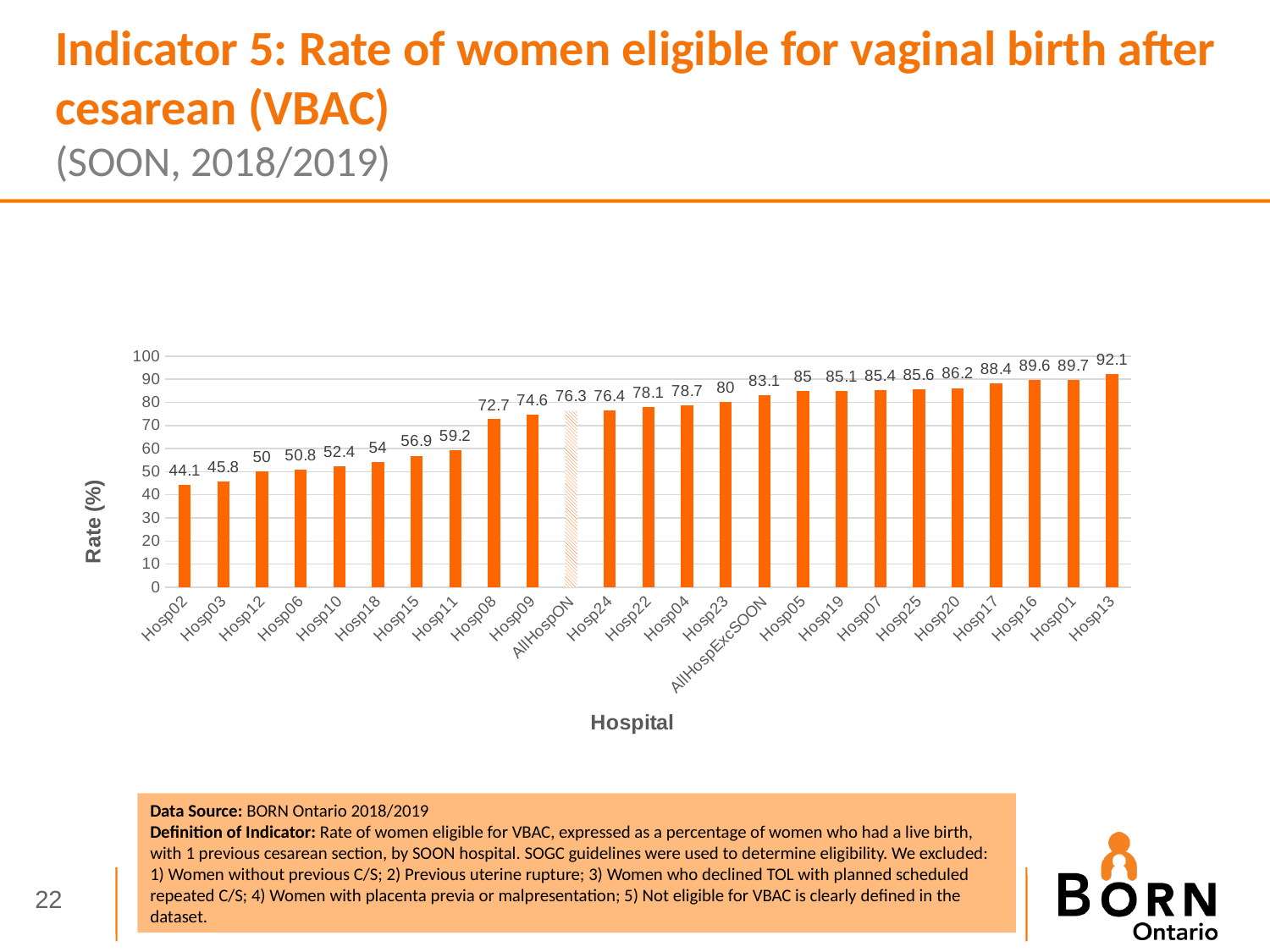
Which hospital has the highest rate? Hosp13 What kind of chart is shown on the slide? Bar chart What is the rate for AllHospExcSOON? 83.1 How many bars are shown on the chart? 25 What is the rate for AllHospON? 76.3 Which has a higher rate, Hosp11 or Hosp09? Hosp09 What is the rate for Hosp08? 72.7 Do the values rise or fall from left to right along the x axis? Rise What is the difference between the rates for Hosp13 and Hosp02? 48 What is the rate for Hosp18? 54 Which hospital has the lowest rate? Hosp02 What is the difference between the rates for Hosp23 and Hosp12? 30